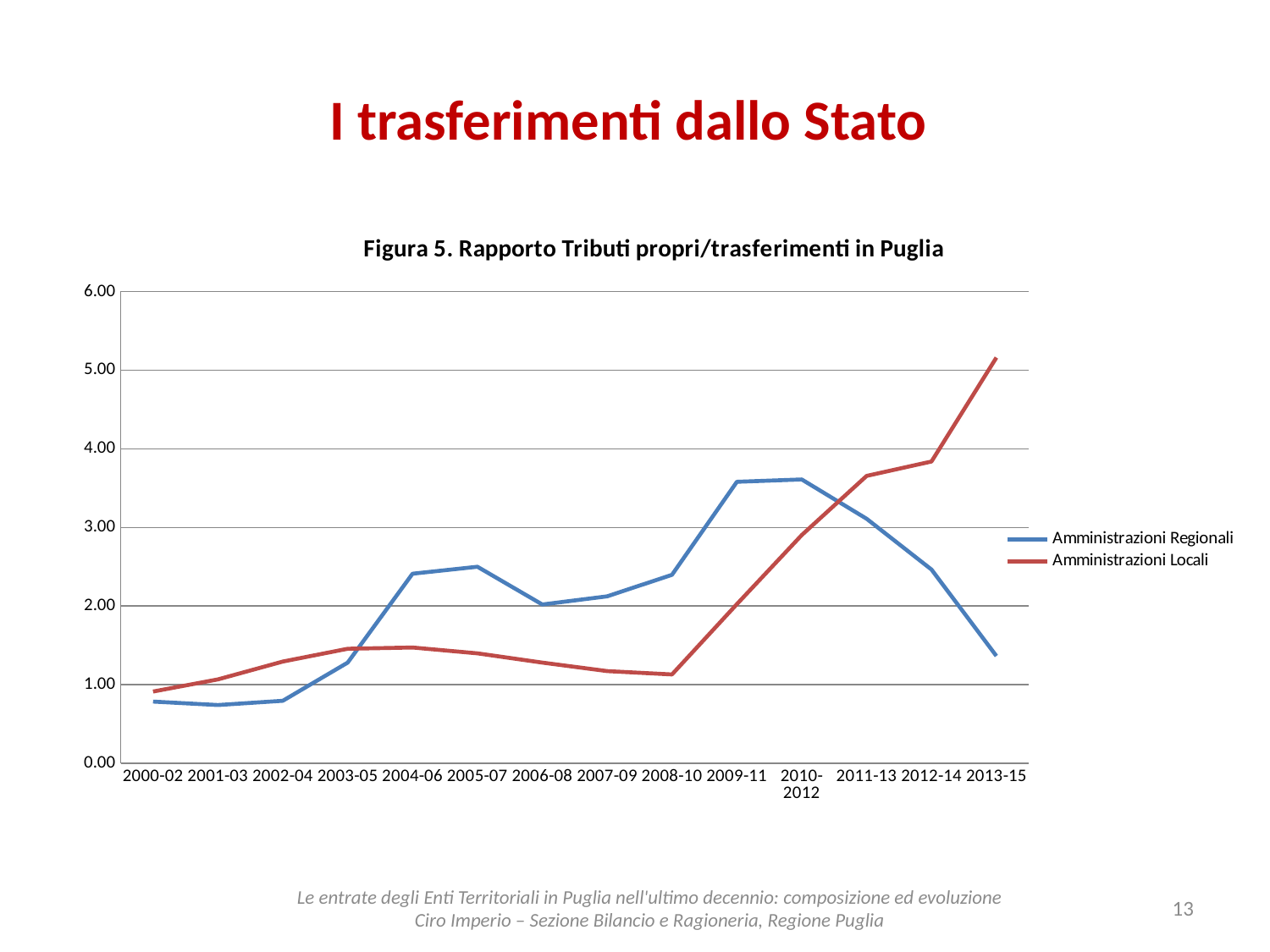
In which period is the Amministrazioni Locali series at its lowest value? 2000-02 What kind of chart is shown on the slide? line chart Is the value for Amministrazioni Locali in 2013-15 greater or less than 5.00? greater Which series has the higher value in 2013-15, Amministrazioni Regionali or Amministrazioni Locali? Amministrazioni Locali Which series has the higher value in 2009-11, Amministrazioni Regionali or Amministrazioni Locali? Amministrazioni Regionali How many periods are plotted along the x axis? 14 Is the value for Amministrazioni Regionali in 2009-11 greater or less than 3.00? greater What is the title of the chart? Figura 5. Rapporto Tributi propri/trasferimenti in Puglia Does the Amministrazioni Locali series rise or fall from 2008-10 to 2013-15? rise Is the value for Amministrazioni Regionali in 2013-15 greater or less than 2.00? less In which period does the Amministrazioni Locali series reach its highest value? 2013-15 How many series does the legend list? 2